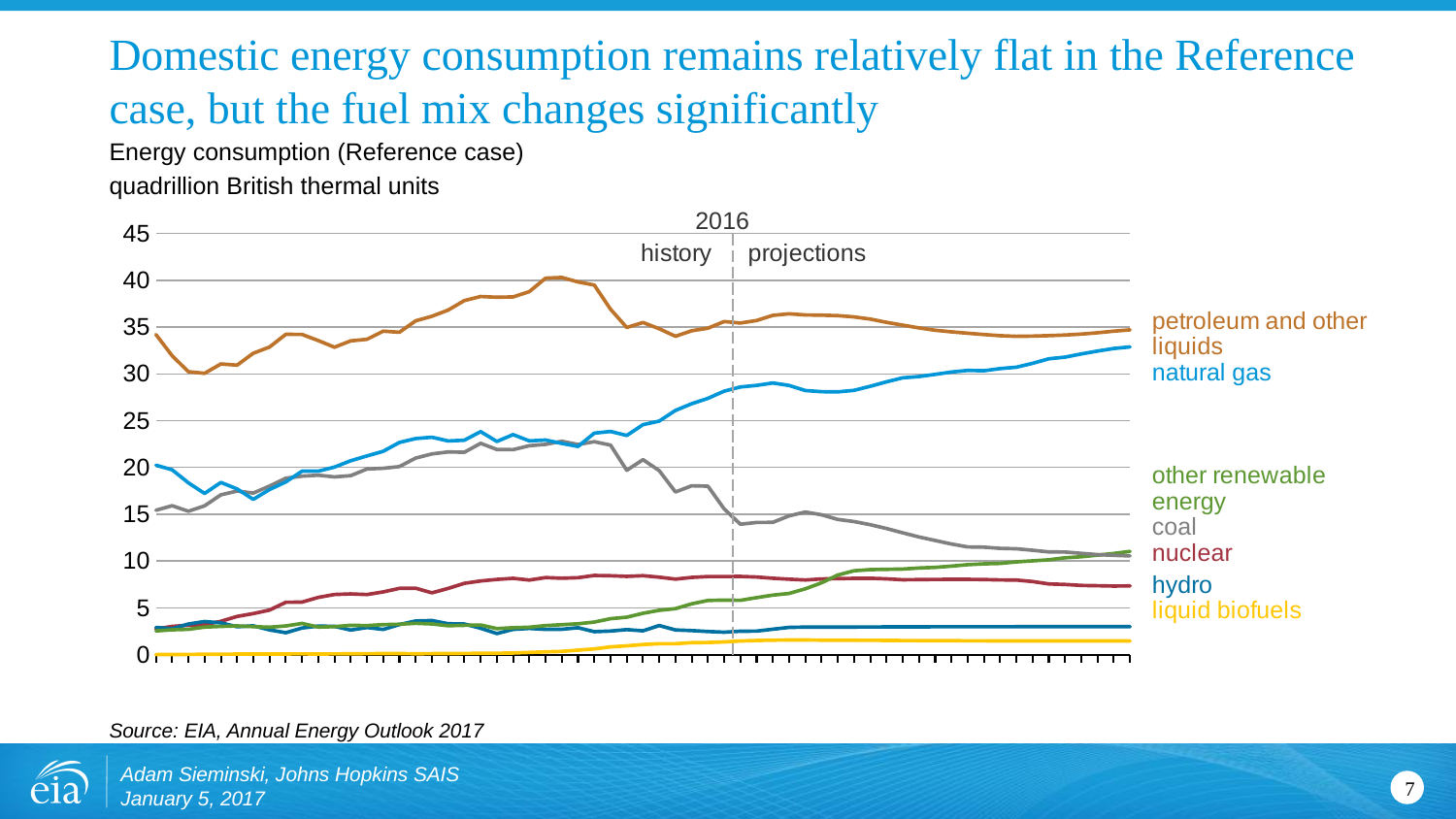
Does the coal series rise or fall across the projections period? fall Does the natural gas series rise or fall across the projections period? rise At the 2016 dashed line, which is larger: natural gas or coal? natural gas Is the value for hydro at the right end of the chart greater or less than 5? less Which series has the lowest value at the right end of the chart? liquid biofuels Is the value for coal at the right end of the chart greater or less than 15? less What kind of chart is shown on the slide? line chart Is the value for natural gas at the 2016 dashed line greater or less than 25? greater What unit is the y axis measured in? quadrillion British thermal units How many series are labelled on the chart? 7 Which series has the highest value at the right end of the chart? petroleum and other liquids